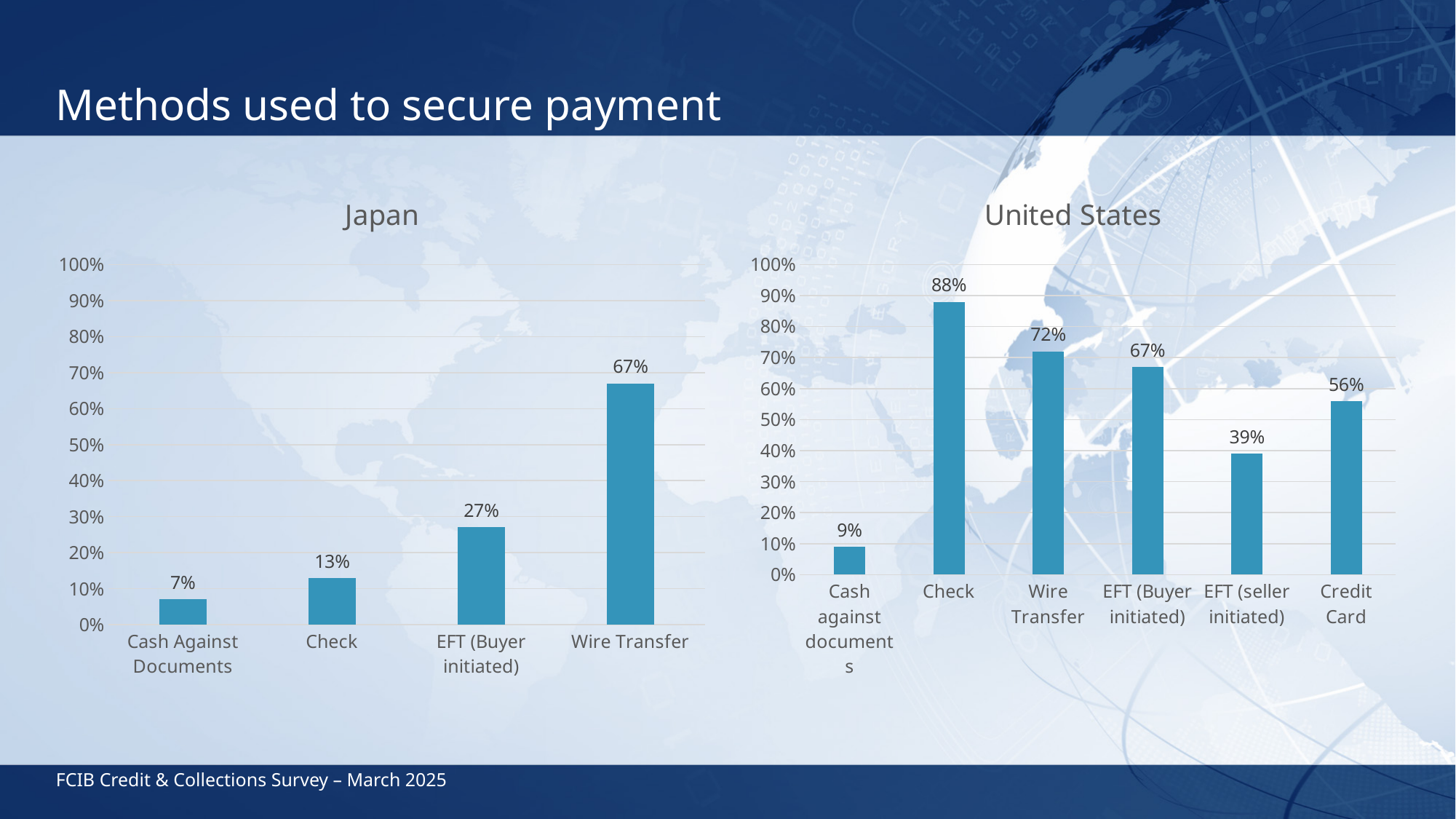
How many categories are shown in the United States chart? 6 In the Japan chart, what is the value for Wire Transfer? 67% In the Japan chart, which category has the lowest value? Cash Against Documents In the Japan chart, which is larger, Check or EFT (Buyer initiated)? EFT (Buyer initiated) What kind of chart is the Japan chart? Bar chart In the Japan chart, what is the difference between Wire Transfer and EFT (Buyer initiated)? 40% In the United States chart, what is the value for Credit Card? 56% In the United States chart, what is the value for EFT (seller initiated)? 39% In the Japan chart, what is the value for Check? 13% How many categories are shown in the Japan chart? 4 In the United States chart, what is the difference between Check and Wire Transfer? 16% In the United States chart, which category has the highest value? Check